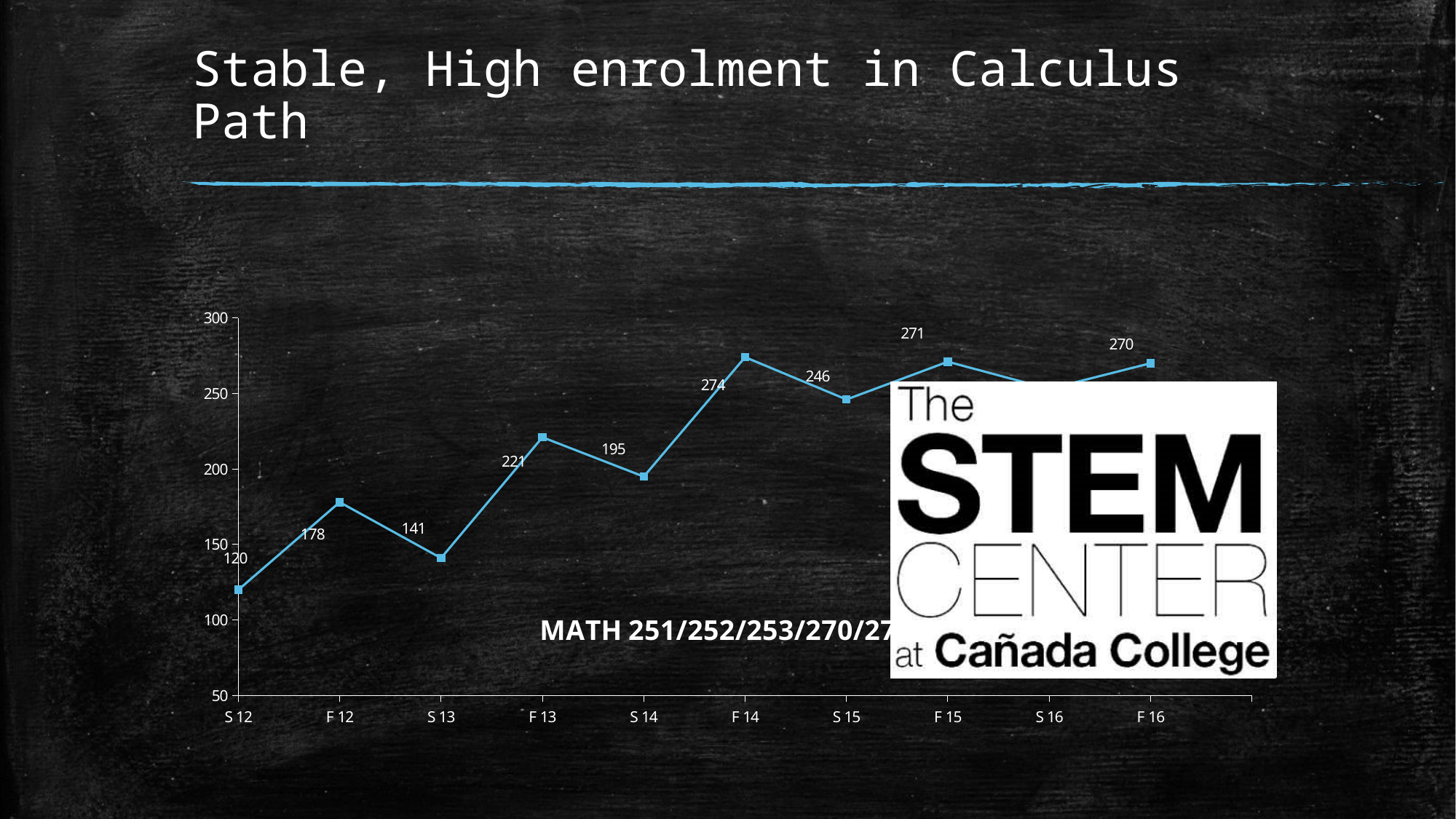
Is the value for S 13 greater or less than 150? less What is the difference between the values for F 13 and S 13? 80 What is the enrolment value for F 14? 274 What is the enrolment value for S 12? 120 What kind of chart is shown on the slide? line chart Which term has the highest enrolment value? F 14 Overall, do the values rise or fall from S 12 to F 16? rise Which is larger, the value for F 12 or the value for S 14? S 14 What is the enrolment value for S 15? 246 Which term has the lowest enrolment value? S 12 How many terms are shown on the x axis? 10 What is the enrolment value for F 16? 270